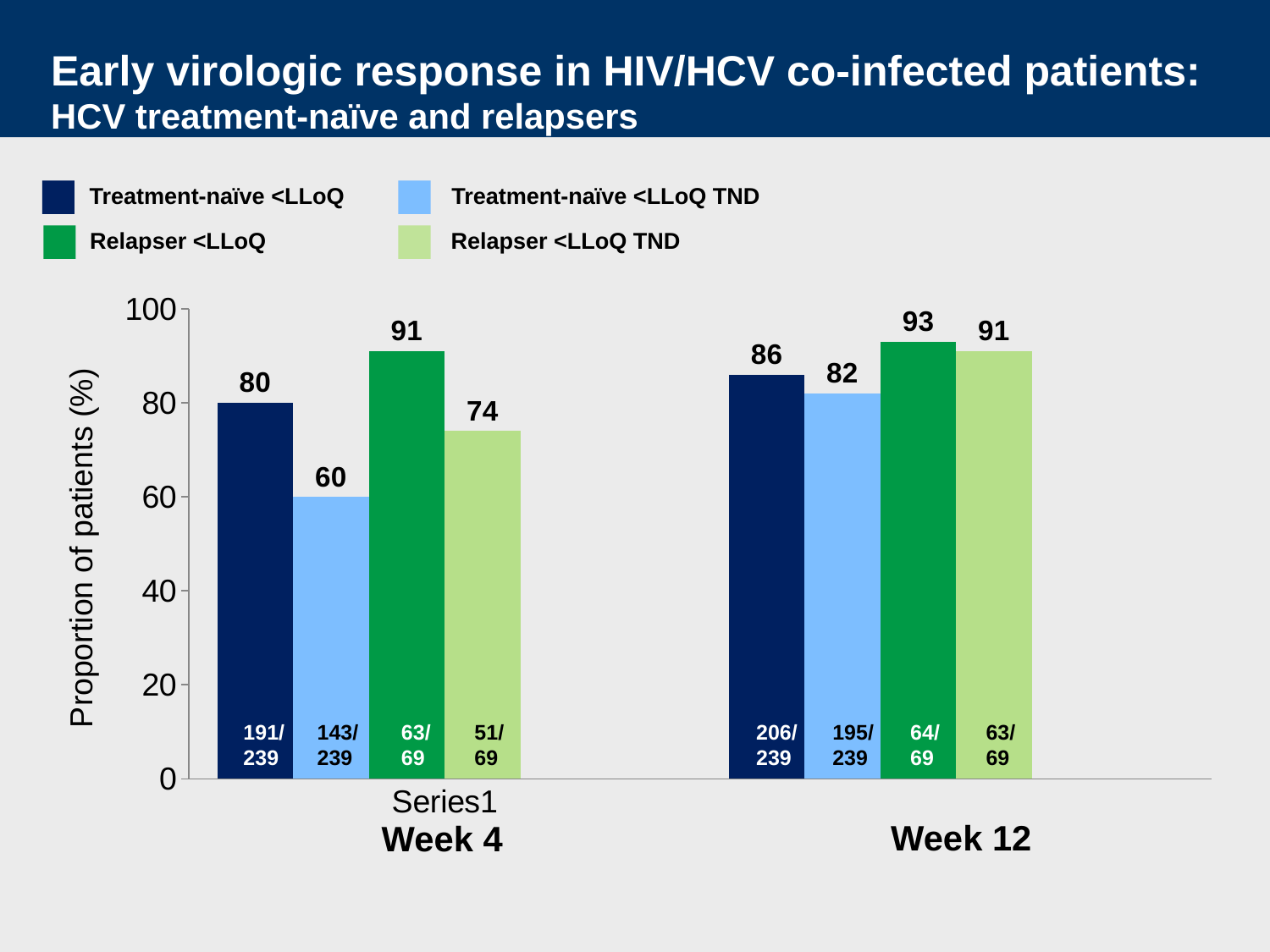
How many series does the legend list? 4 What is the y-axis label of the chart? Proportion of patients (%) What is the difference between the Relapser <LLoQ value and the Treatment-naïve <LLoQ value at Week 4? 11 What kind of chart is shown on the slide? Bar chart Which series has the highest value at Week 12? Relapser <LLoQ What is the value for Treatment-naïve <LLoQ at Week 4? 80 What is the value for Relapser <LLoQ TND at Week 12? 91 What is the value for Treatment-naïve <LLoQ TND at Week 4? 60 Which is larger at Week 12: Treatment-naïve <LLoQ or Treatment-naïve <LLoQ TND? Treatment-naïve <LLoQ Does the value for Relapser <LLoQ TND rise or fall from Week 4 to Week 12? Rise What fraction is printed inside the Treatment-naïve <LLoQ bar at Week 12? 206/239 Which series has the lowest value at Week 4? Treatment-naïve <LLoQ TND